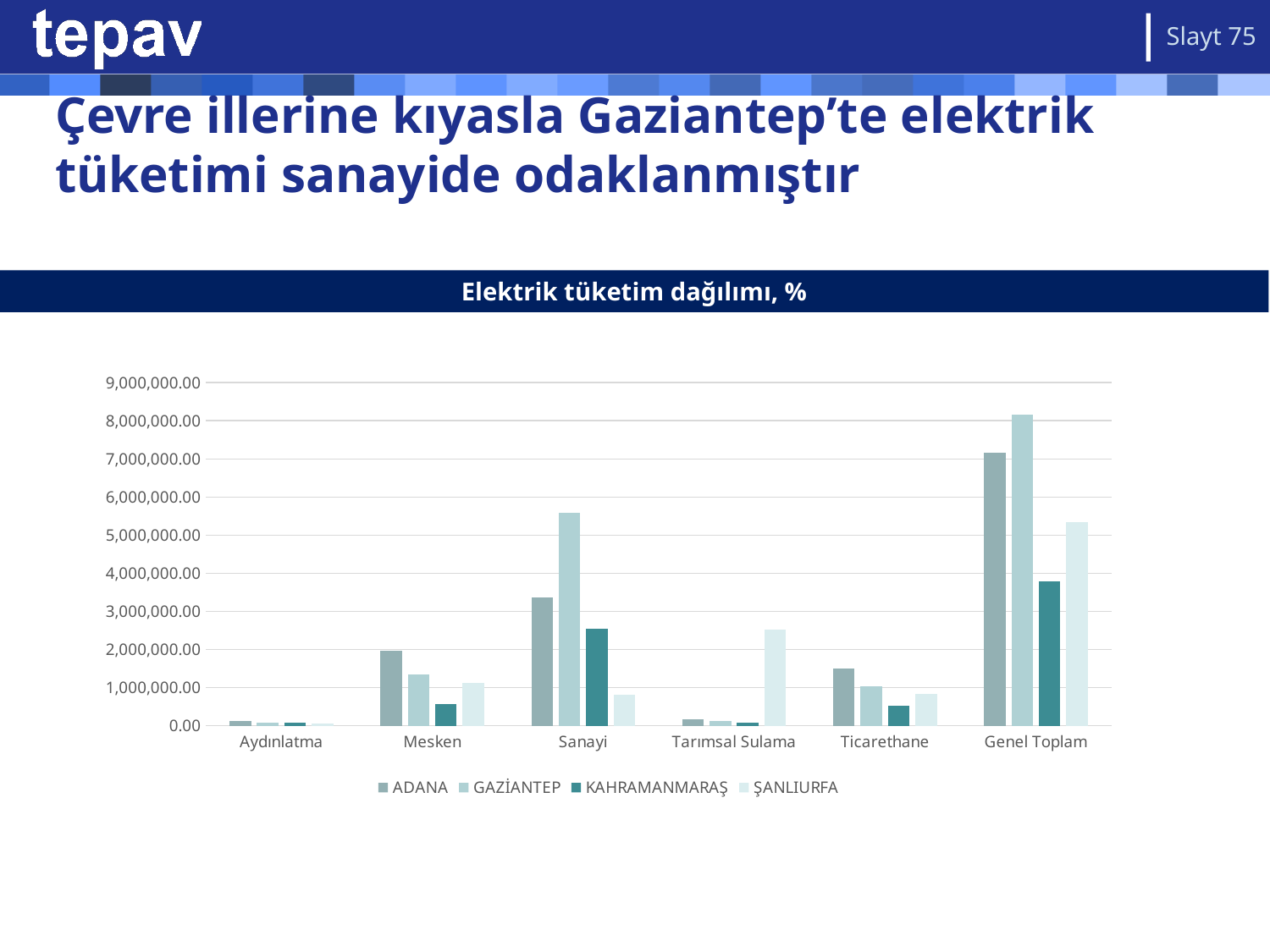
Which province has the lowest value for Mesken? KAHRAMANMARAŞ Is the value for ADANA in Genel Toplam greater or less than 6,000,000.00? greater Which province has the highest value for Tarımsal Sulama? ŞANLIURFA Is the value for GAZİANTEP in Sanayi greater or less than 5,000,000.00? greater How many series does the legend list? 4 Is the value for KAHRAMANMARAŞ in Genel Toplam greater or less than 4,000,000.00? less What is the title of the chart? Elektrik tüketim dağılımı, % Which province has the highest value for Sanayi? GAZİANTEP In the Mesken category, which is larger: ADANA or GAZİANTEP? ADANA What kind of chart is shown on the slide? bar chart Which province has the highest value for Genel Toplam? GAZİANTEP How many categories are shown on the x axis? 6